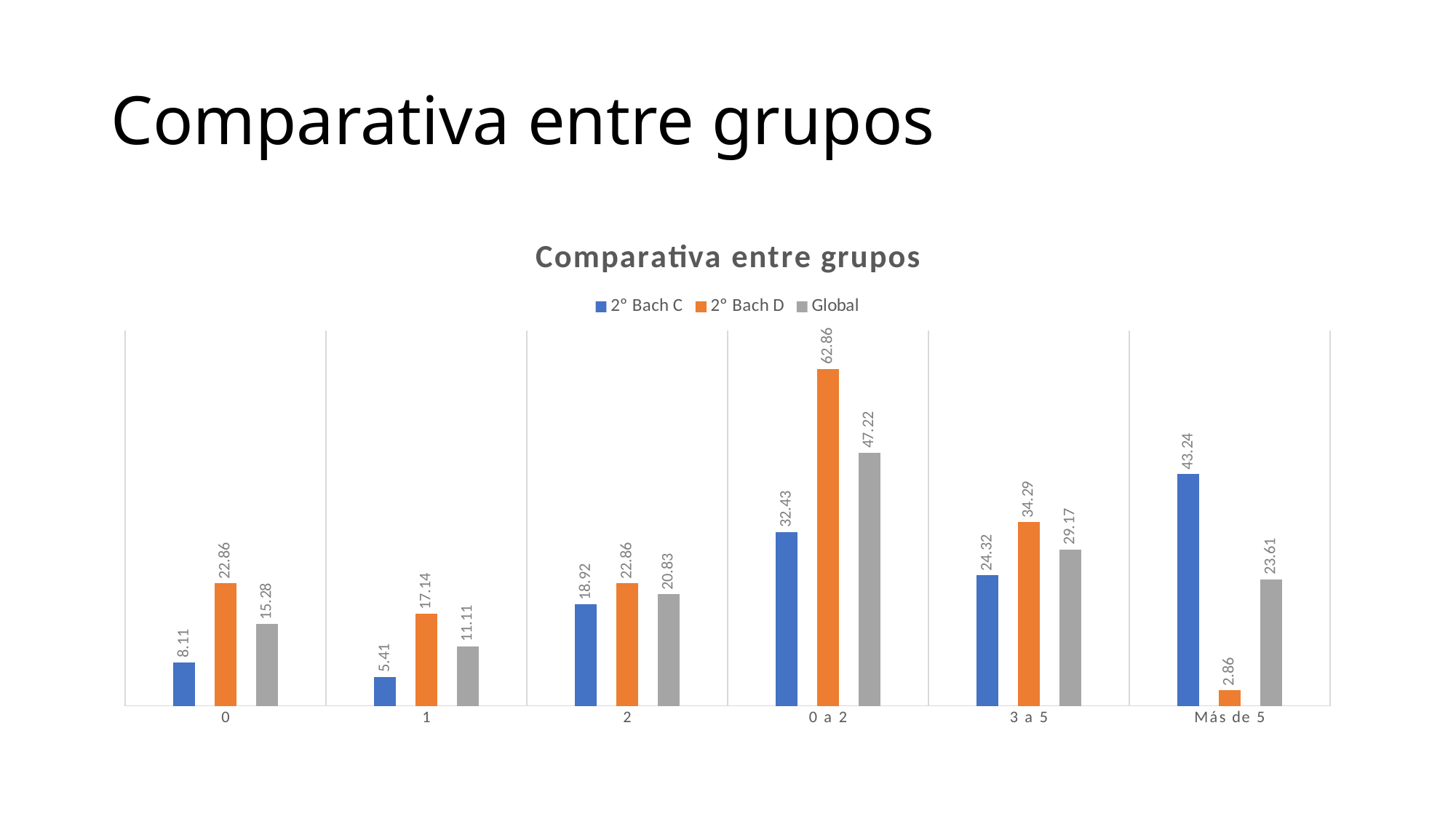
Which category has the highest value for 2° Bach C? Más de 5 Which is larger in the "3 a 5" category: 2° Bach C or 2° Bach D? 2° Bach D How many categories are shown on the x axis? 6 What is the Global value for category 1? 11.11 What is the difference between the 2° Bach D and 2° Bach C values in the "0 a 2" category? 30.43 What is the value for 2° Bach C in the "Más de 5" category? 43.24 What kind of chart is shown on the slide? Bar chart Which colour represents the Global series? Grey Which category has the lowest value for 2° Bach D? Más de 5 What is the value for 2° Bach D in the "0 a 2" category? 62.86 What is the title of the chart? Comparativa entre grupos How many series does the legend list? 3